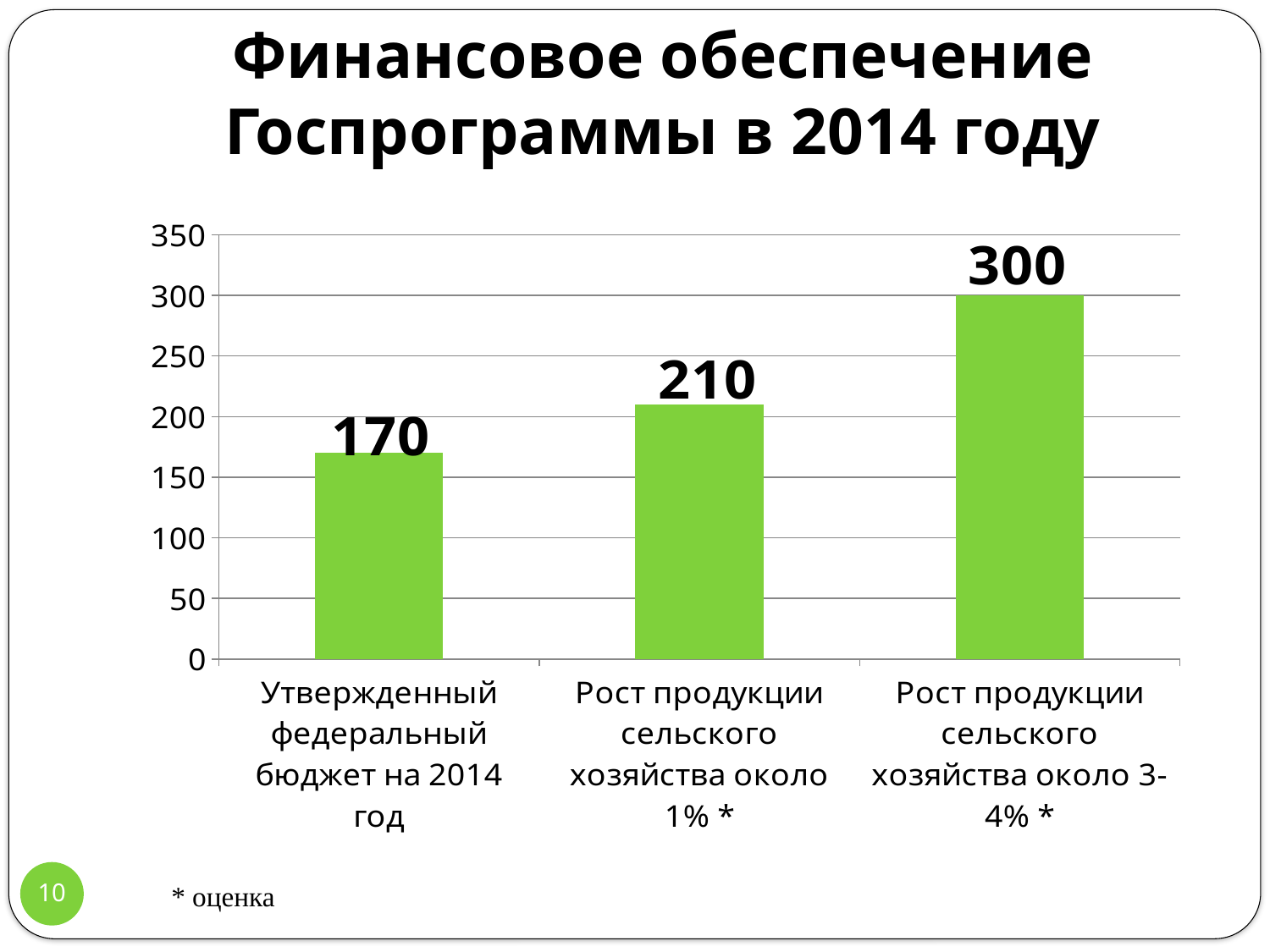
What is the value for "Рост продукции сельского хозяйства около 1% *"? 210 Do the values rise or fall from left to right across the categories? rise What is the difference between the values for "Рост продукции сельского хозяйства около 1% *" and "Утвержденный федеральный бюджет на 2014 год"? 40 Which category has the highest value? Рост продукции сельского хозяйства около 3-4% * Is the value for "Утвержденный федеральный бюджет на 2014 год" greater or less than 200? less How many categories are shown in the chart? 3 What is the value for "Рост продукции сельского хозяйства около 3-4% *"? 300 What is the difference between the values for "Рост продукции сельского хозяйства около 3-4% *" and "Утвержденный федеральный бюджет на 2014 год"? 130 What is the value for "Утвержденный федеральный бюджет на 2014 год"? 170 Which category has the lowest value? Утвержденный федеральный бюджет на 2014 год Which is larger: the value for "Рост продукции сельского хозяйства около 1% *" or for "Утвержденный федеральный бюджет на 2014 год"? Рост продукции сельского хозяйства около 1% * What kind of chart is shown on the slide? bar chart